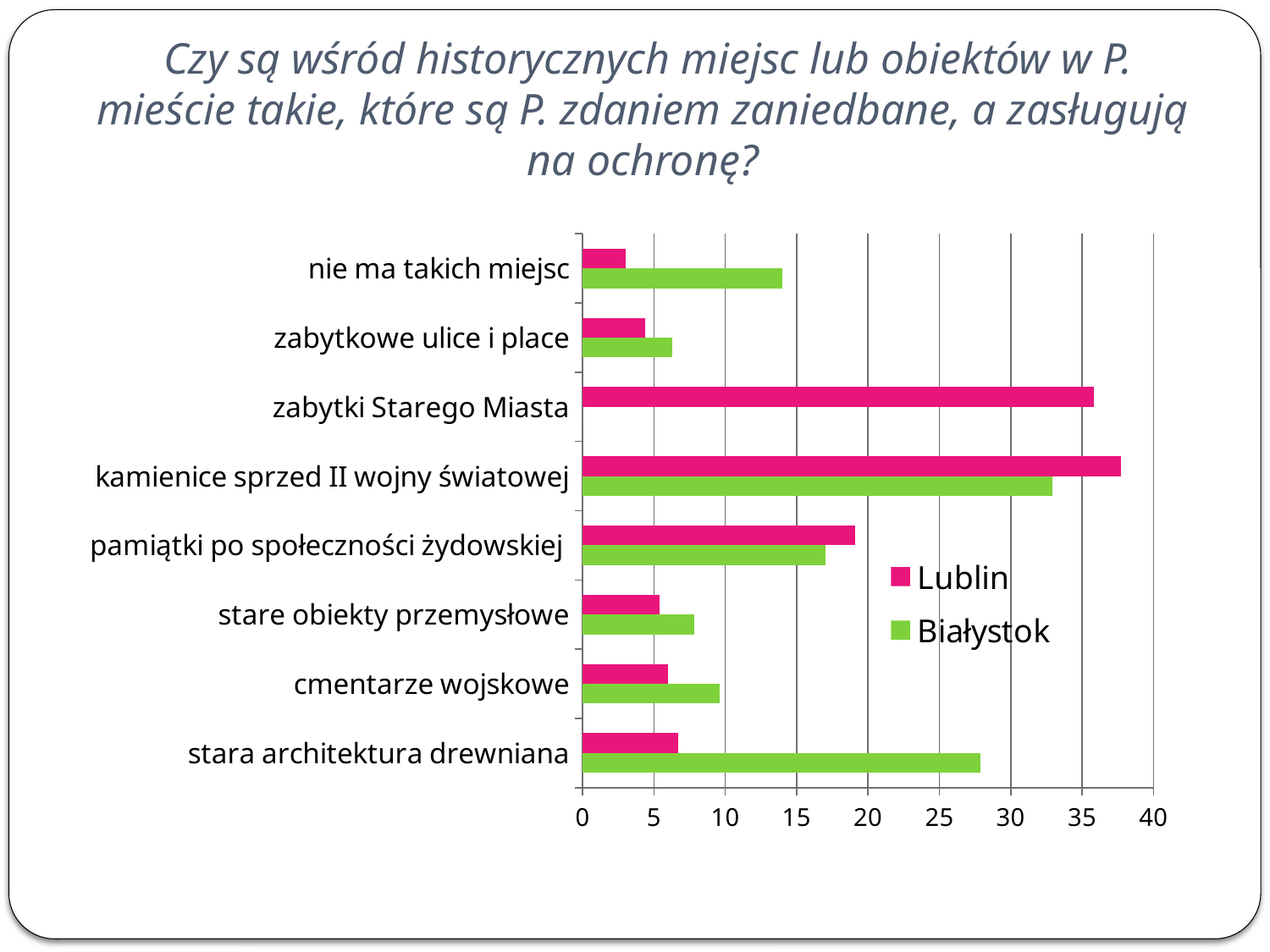
Which category has the highest value for Lublin? kamienice sprzed II wojny światowej Which category has the highest value for Białystok? kamienice sprzed II wojny światowej Is the Białystok value for 'stara architektura drewniana' greater or less than 25? greater What kind of chart is shown on the slide? bar chart Is the Lublin value for 'nie ma takich miejsc' greater or less than 5? less For 'kamienice sprzed II wojny światowej', which series has the larger value, Lublin or Białystok? Lublin How many series does the legend list? 2 How many categories are shown on the chart? 8 Is the Lublin value for 'zabytki Starego Miasta' greater or less than 35? greater Which colour represents Białystok in the legend? green Which category has the lowest value for Lublin? nie ma takich miejsc For 'nie ma takich miejsc', which series has the larger value, Lublin or Białystok? Białystok